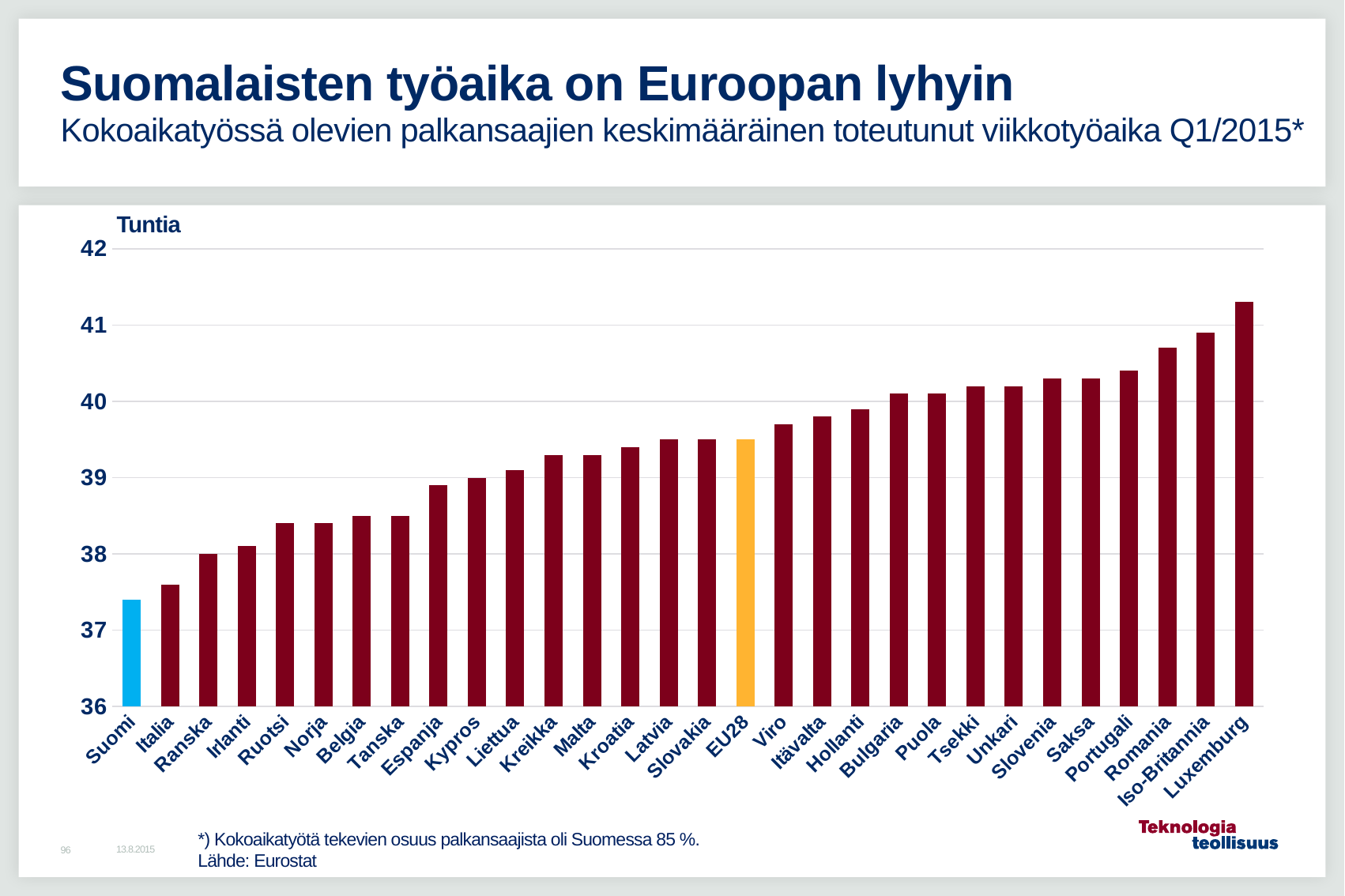
What kind of chart is shown on the slide? bar chart Do the bar values rise or fall from left to right along the x axis? rise How many bars (categories) are plotted in the chart? 30 Which bar is coloured orange in the chart? EU28 Which country has the lowest average weekly working time in the chart? Suomi What unit label is shown at the top of the vertical axis? Tuntia Is the value for Saksa greater or less than 40? greater Is the value for Suomi greater or less than 38? less Is the value for EU28 greater or less than 40? less Which has a larger value, Romania or Espanja? Romania Which country has the highest average weekly working time in the chart? Luxemburg